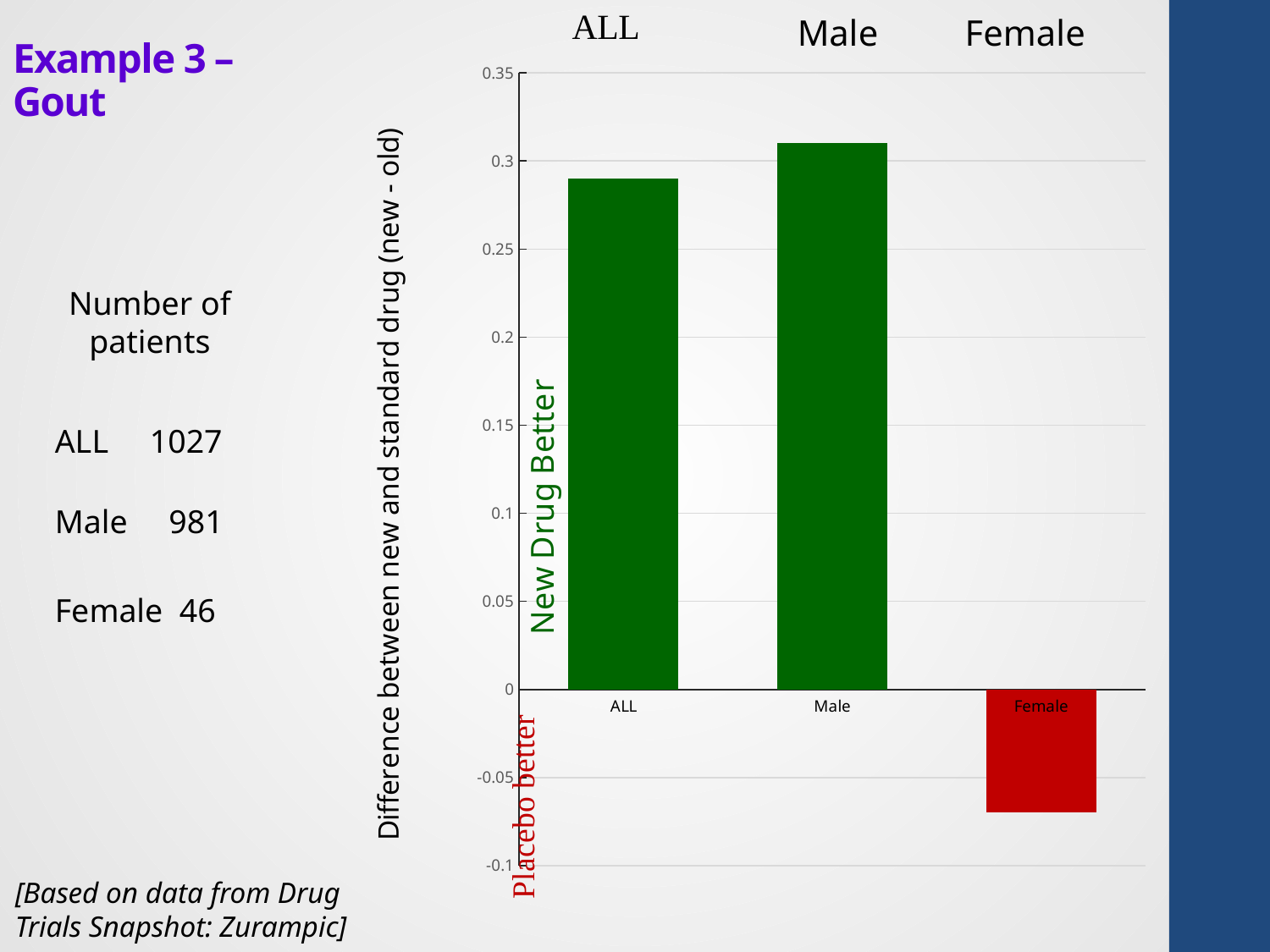
What is the label of the vertical axis of the chart? Difference between new and standard drug (new - old) Which category has a negative value in the chart? Female Is the value for Female greater or less than -0.1? greater Is the value for ALL greater or less than 0.25? greater Which category has the highest value in the chart? Male How many categories are plotted in the chart? 3 What kind of chart is shown on the slide? bar chart Is the value for Male greater or less than 0.25? greater Which category has the lowest value in the chart? Female Which is larger, the value for ALL or the value for Male? Male